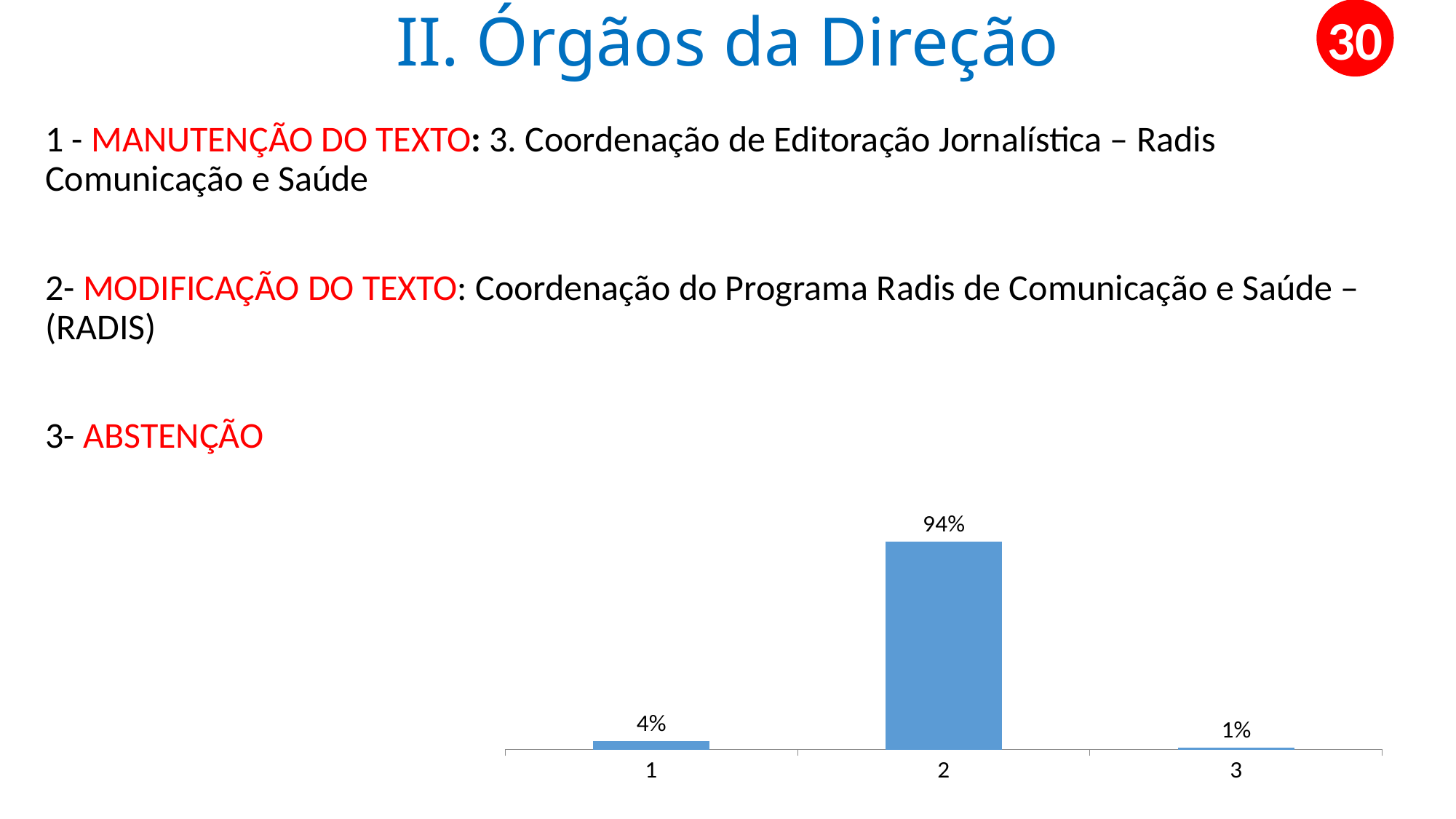
What is the value for category 1 in the bar chart? 4% Which is larger, the value for category 1 or the value for category 3? 1 Which option does category 3 on the chart correspond to according to the slide text? ABSTENÇÃO Which category has the highest value in the bar chart? 2 What is the value for category 3 in the bar chart? 1% What colour are the bars in the chart? blue What is the difference between the values for category 1 and category 3? 3% What kind of chart is shown on the slide? bar chart What is the value for category 2 in the bar chart? 94% What is the difference between the values for category 2 and category 1? 90% How many categories are shown on the x axis of the bar chart? 3 Which category has the lowest value in the bar chart? 3